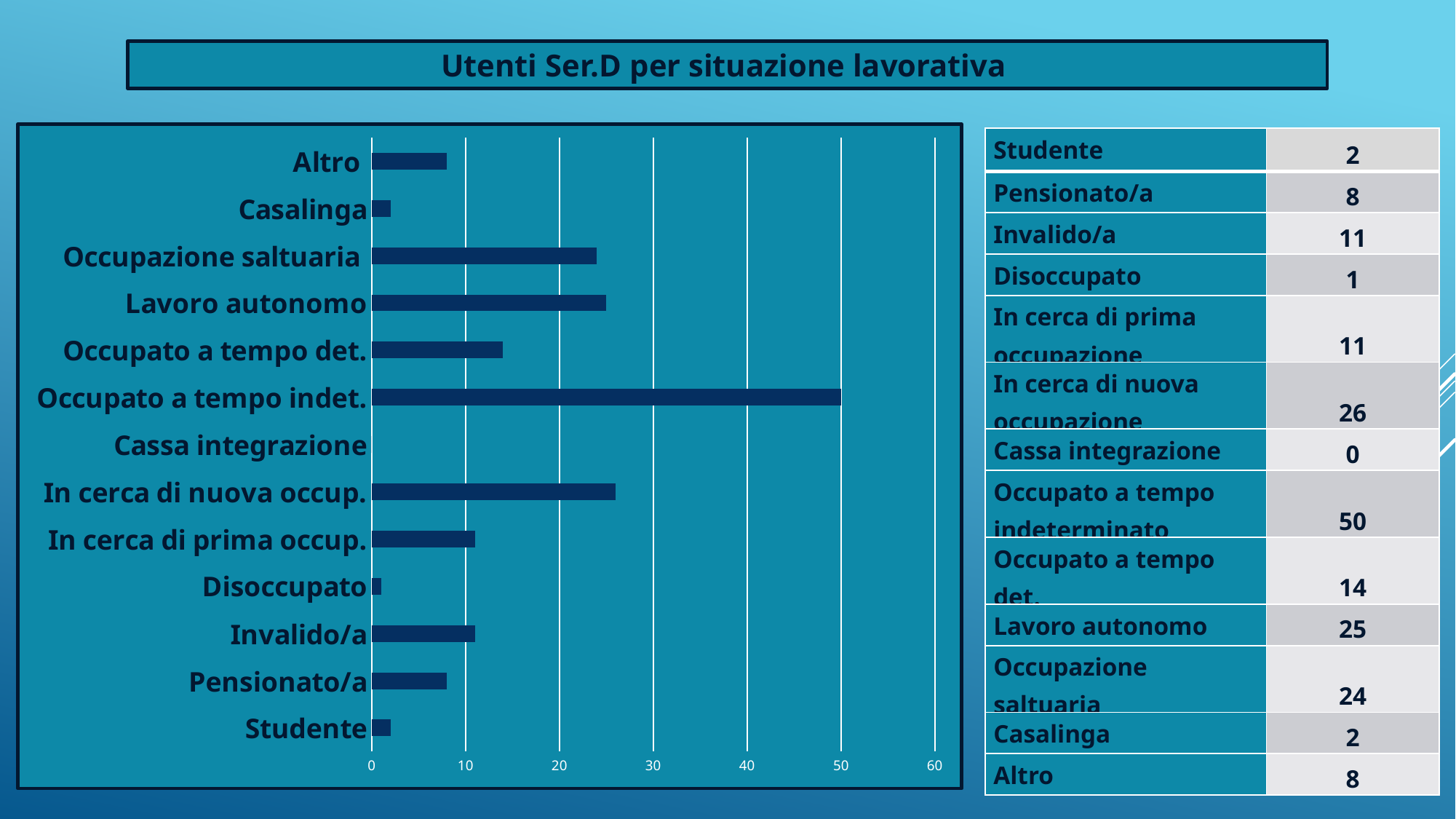
What is the value for In cerca di nuova occupazione? 26 What is the value for Pensionato/a? 8 Which category has the highest value? Occupato a tempo indet. Which is larger, the value for Occupato a tempo indet. or the value for Lavoro autonomo? Occupato a tempo indet. What is the difference between the values for Occupato a tempo indeterminato and In cerca di nuova occupazione? 24 What kind of chart is shown on the slide? bar chart What is the title of the chart? Utenti Ser.D per situazione lavorativa How many categories are plotted in the chart? 13 What is the value for Occupato a tempo det.? 14 What is the value for Occupato a tempo indeterminato? 50 Which category has the lowest value? Cassa integrazione Is the value for Occupazione saltuaria greater or less than 30? less